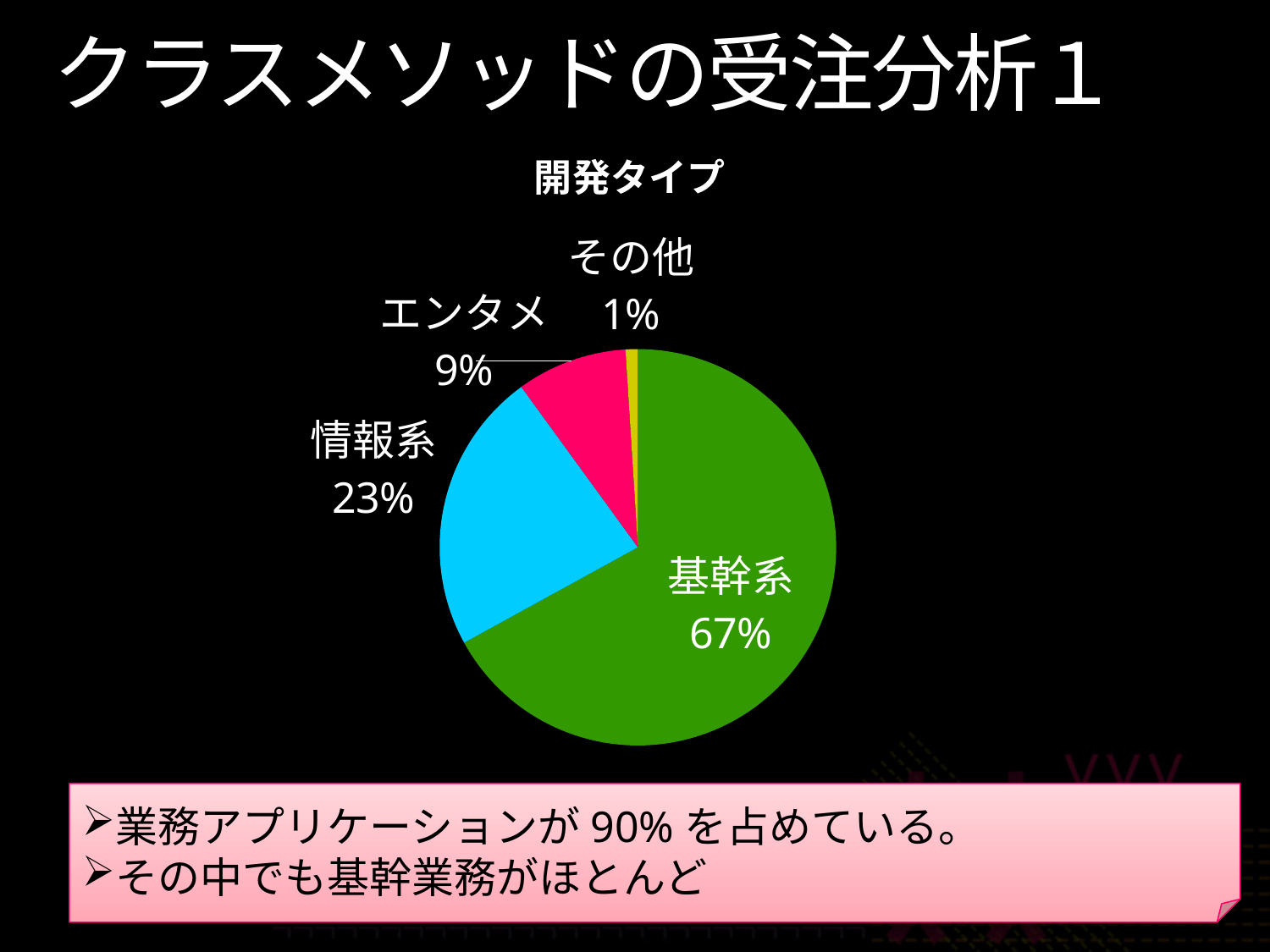
How many slices does the pie chart have? 4 What is the difference in percentage points between 基幹系 and 情報系? 44 Which category has the largest slice of the pie? 基幹系 Which category has the smallest slice of the pie? その他 What is the title of the chart? 開発タイプ What type of chart is shown on the slide? pie chart What colour is the 基幹系 slice? green Which is larger, the share for 情報系 or the share for エンタメ? 情報系 What share of the pie does その他 hold? 1% What share of the pie does 情報系 hold? 23% What share of the pie does エンタメ hold? 9%